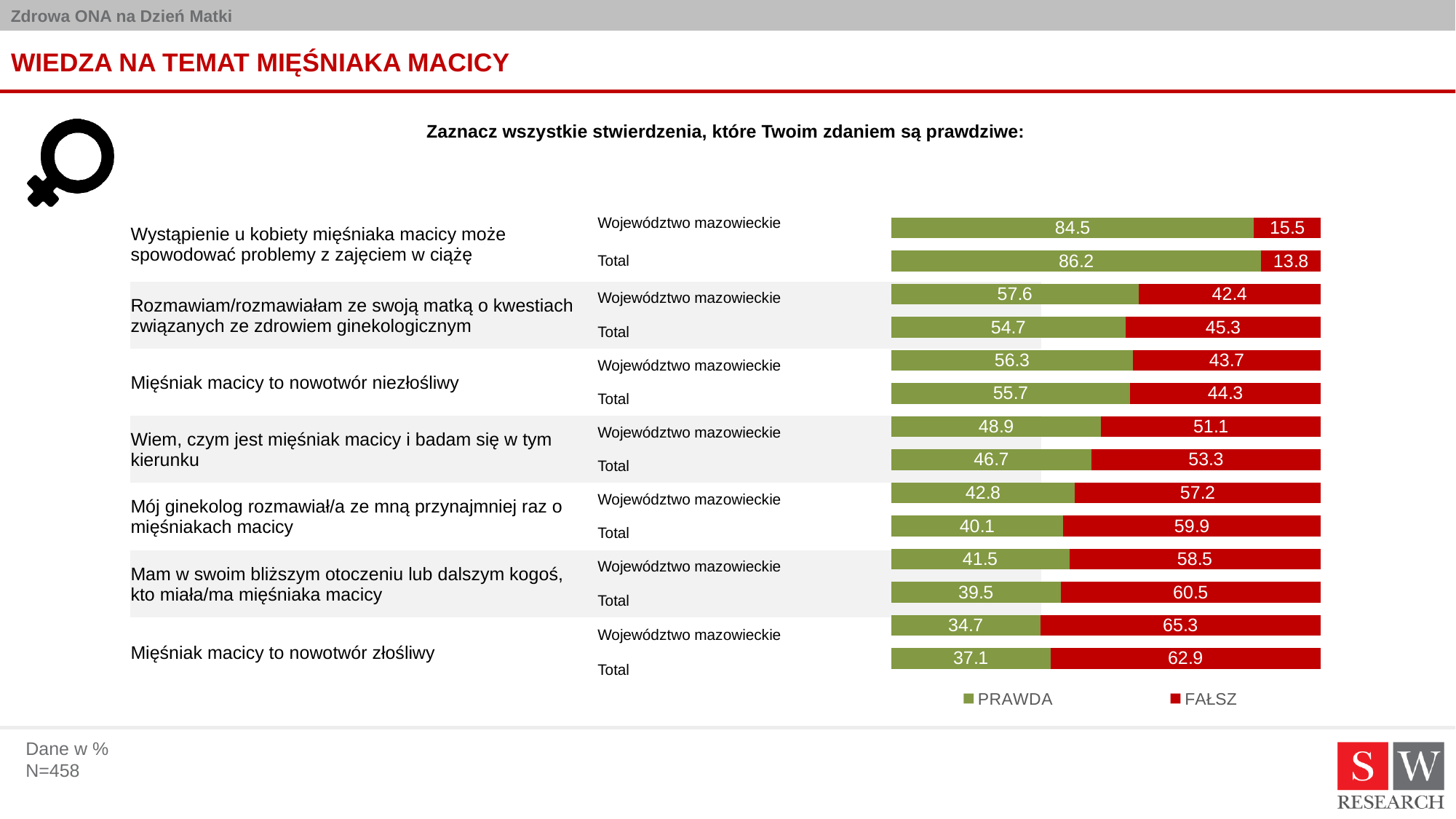
What is the PRAWDA value for 'Total' for the statement 'Wystąpienie u kobiety mięśniaka macicy może spowodować problemy z zajęciem w ciążę'? 86.2 Which statement has the highest PRAWDA value for 'Total'? Wystąpienie u kobiety mięśniaka macicy może spowodować problemy z zajęciem w ciążę What is the PRAWDA value for 'Województwo mazowieckie' for the statement 'Rozmawiam/rozmawiałam ze swoją matką o kwestiach związanych ze zdrowiem ginekologicznym'? 57.6 Which statement has the lowest PRAWDA value for 'Województwo mazowieckie'? Mięśniak macicy to nowotwór złośliwy What is the FAŁSZ value for 'Województwo mazowieckie' for the statement 'Mięśniak macicy to nowotwór złośliwy'? 65.3 What is the total of the stacked bar for 'Total' for the statement 'Mięśniak macicy to nowotwór niezłośliwy'? 100 What is the difference between the PRAWDA values for 'Województwo mazowieckie' and 'Total' for the statement 'Mój ginekolog rozmawiał/a ze mną przynajmniej raz o mięśniakach macicy'? 2.7 How many statements are shown in the chart? 7 What kind of chart is shown on the slide? Stacked bar chart For the statement 'Wiem, czym jest mięśniak macicy i badam się w tym kierunku', is the PRAWDA value higher for 'Województwo mazowieckie' or for 'Total'? Województwo mazowieckie How many series does the legend list? 2 Which colour represents the FAŁSZ series in the chart? Red